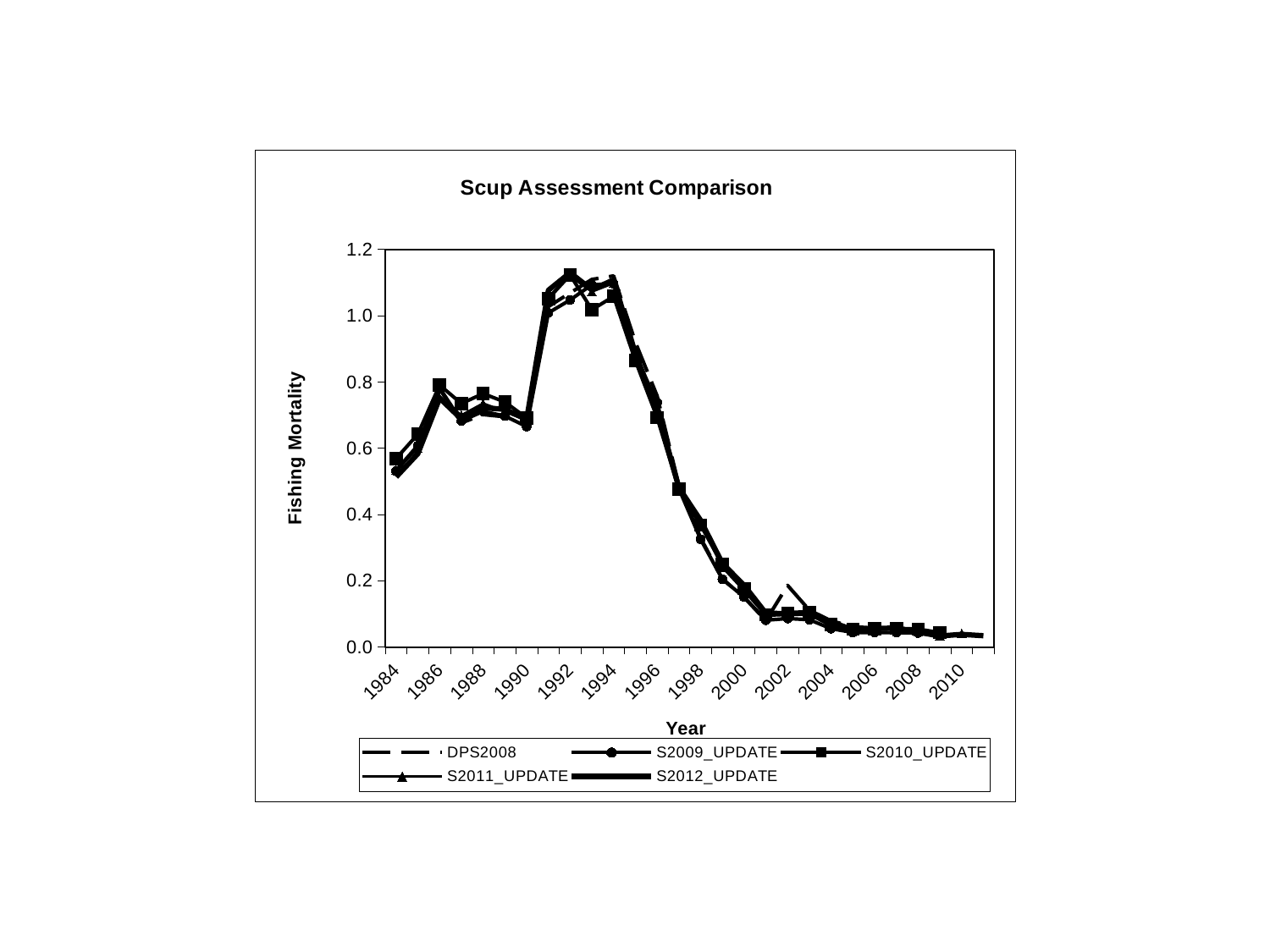
Is the S2010_UPDATE value for 1986 greater or less than 0.6? greater Is the S2010_UPDATE value for 1992 greater or less than 1.0? greater How many year labels are shown along the x axis? 14 What is the title of the chart? Scup Assessment Comparison What is the label of the y axis? Fishing Mortality Is the S2010_UPDATE value for 1998 greater or less than 0.6? less Which is larger for S2010_UPDATE, the value for 1992 or the value for 2000? 1992 Do the fishing mortality values rise or fall from 1994 to 2010? fall What kind of chart is shown on the slide? line chart How many series does the legend list? 5